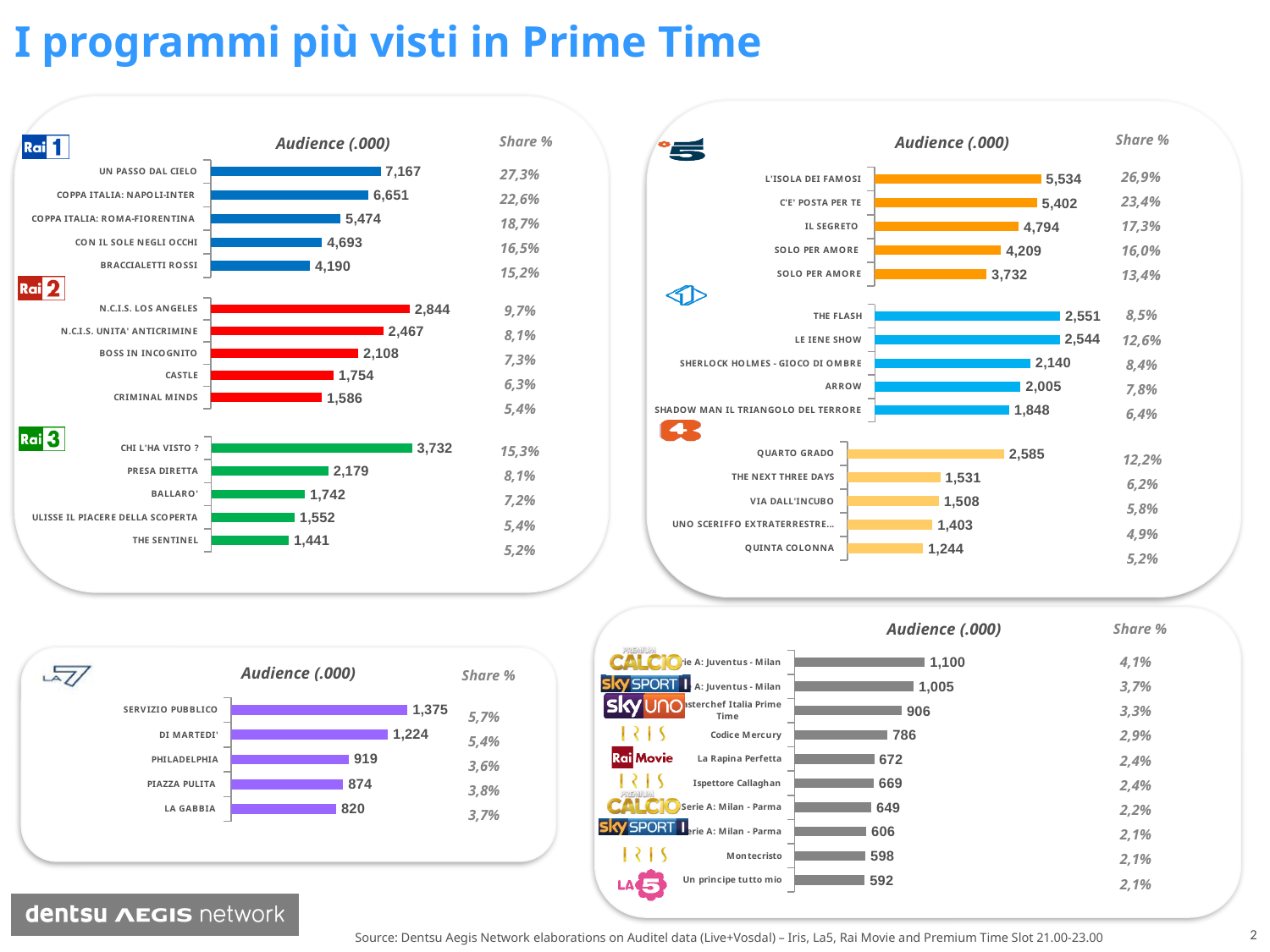
In the bottom-right chart, what is the audience (.000) for Codice Mercury? 786 What type of chart is used for the Rai 1 data? Bar chart In the Italia 1 chart, which programme has the lowest audience? SHADOW MAN IL TRIANGOLO DEL TERRORE In the Rete 4 chart, what is the share % for QUARTO GRADO? 12,2% In the Rai 1 chart, do the audience values rise or fall from top to bottom? Fall In the La7 chart (bottom left), how many programmes are listed? 5 In the Rai 3 chart, what is the difference in audience (.000) between CHI L'HA VISTO ? and THE SENTINEL? 2,291 In the Rai 1 chart, what is the audience (.000) for UN PASSO DAL CIELO? 7,167 In the Canale 5 chart (top right panel), what is the audience (.000) for IL SEGRETO? 4,794 In the La7 chart, which has the larger audience, PHILADELPHIA or PIAZZA PULITA? PHILADELPHIA In the Rai 2 chart, which programme has the highest audience? N.C.I.S. LOS ANGELES In the bottom-right chart, how many programmes are listed? 10